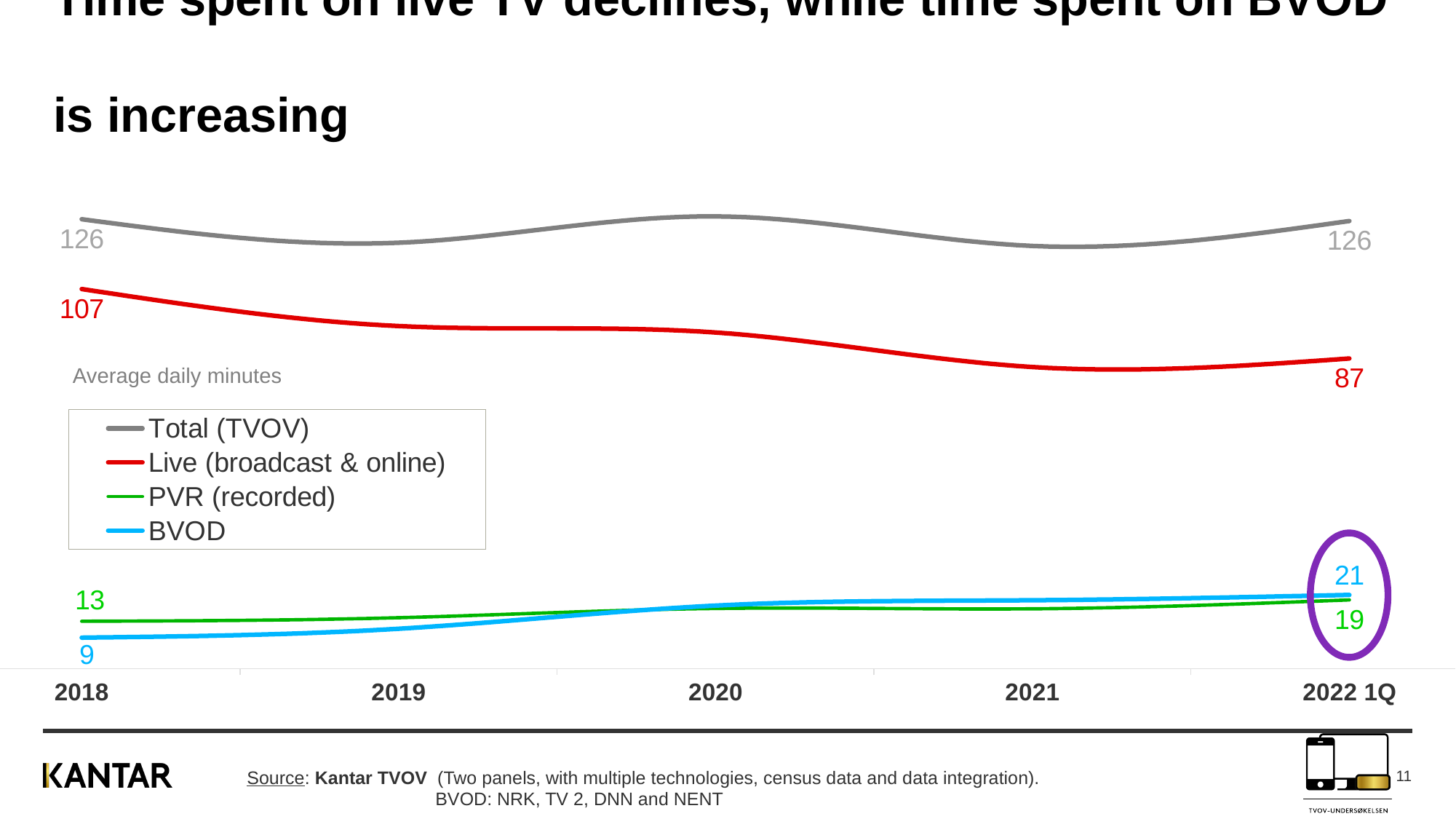
What is the value for Total (TVOV) in 2022 1Q? 126 What is the value for BVOD in 2022 1Q? 21 Does the Live (broadcast & online) line rise or fall from 2018 to 2022 1Q? Fall What is the value for PVR (recorded) in 2018? 13 How many series does the legend list? 4 What is the value for Live (broadcast & online) in 2018? 107 What type of chart is shown on the slide? Line chart Which series has the lowest value in 2018? BVOD What is the value for Live (broadcast & online) in 2022 1Q? 87 How many time points are shown on the x axis? 5 By how much did Live (broadcast & online) change from 2018 to 2022 1Q? 20 By how much did BVOD increase from 2018 to 2022 1Q? 12